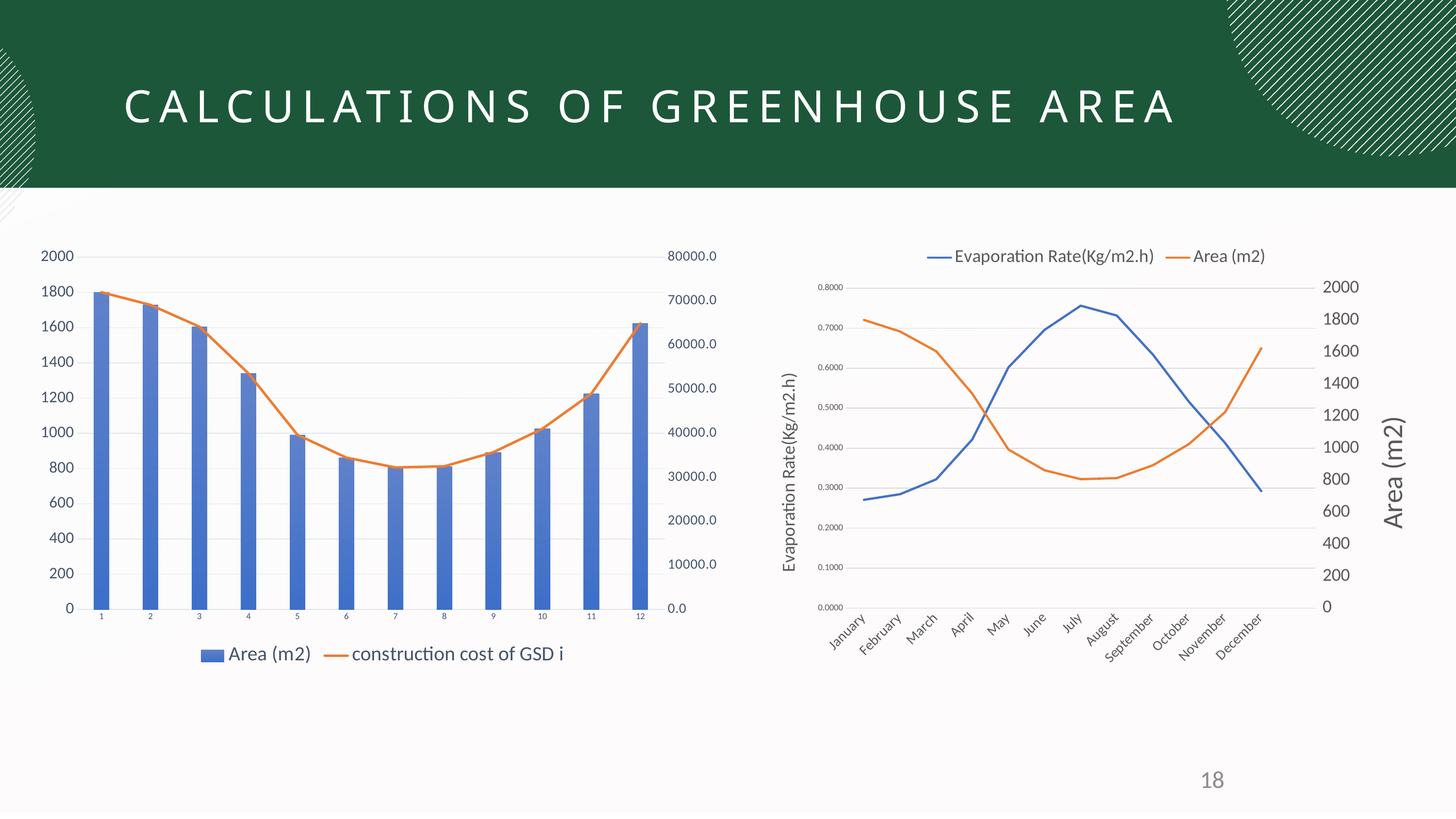
On the left chart, which category has the tallest Area (m2) bar? 1 On the left chart, is the Area (m2) value for category 4 greater or less than 1200? greater What kind of chart is the right chart? line chart On the right chart, in which month does the Evaporation Rate(Kg/m2.h) reach its highest value? July On the left chart, which is larger, the Area (m2) bar for category 3 or for category 9? category 3 On the right chart, is the Evaporation Rate(Kg/m2.h) for July greater or less than 0.7000? greater On the right chart, is the Area (m2) value for December greater or less than 1400? greater On the right chart, in which month is the Evaporation Rate(Kg/m2.h) lowest? January On the left chart, how many categories are shown on the x axis? 12 On the left chart, how many series does the legend list? 2